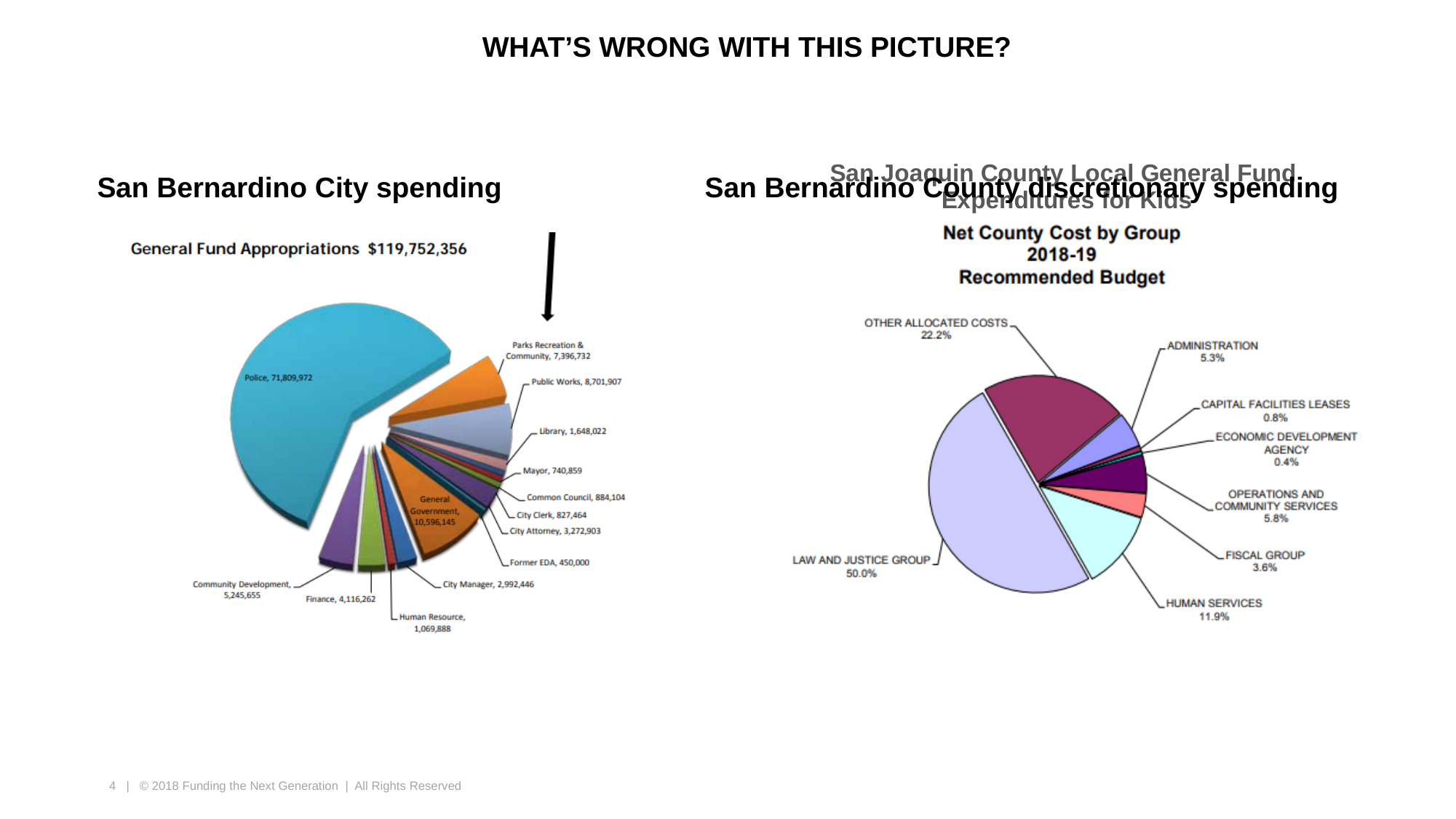
In the left chart (General Fund Appropriations), what is the difference between General Government and Finance? 6,479,883 How many categories are shown in the left chart (General Fund Appropriations)? 14 In the right chart (Net County Cost by Group), what is the difference between Other Allocated Costs and Administration? 16.9% In the right chart (Net County Cost by Group), what share does the Law and Justice Group have? 50.0% In the left chart (General Fund Appropriations), which category has the smallest value? Former EDA In the right chart (Net County Cost by Group), which category has the smallest share? Economic Development Agency In the left chart (General Fund Appropriations), which category has the largest value? Police In the left chart (General Fund Appropriations), which is larger: Library or Human Resource? Library In the left chart (General Fund Appropriations), what is the value for Police? 71,809,972 In the left chart (General Fund Appropriations), what is the value for Public Works? 8,701,907 What kind of chart is the right chart (Net County Cost by Group 2018-19 Recommended Budget)? Pie chart In the right chart (Net County Cost by Group), what is the value for Human Services? 11.9%